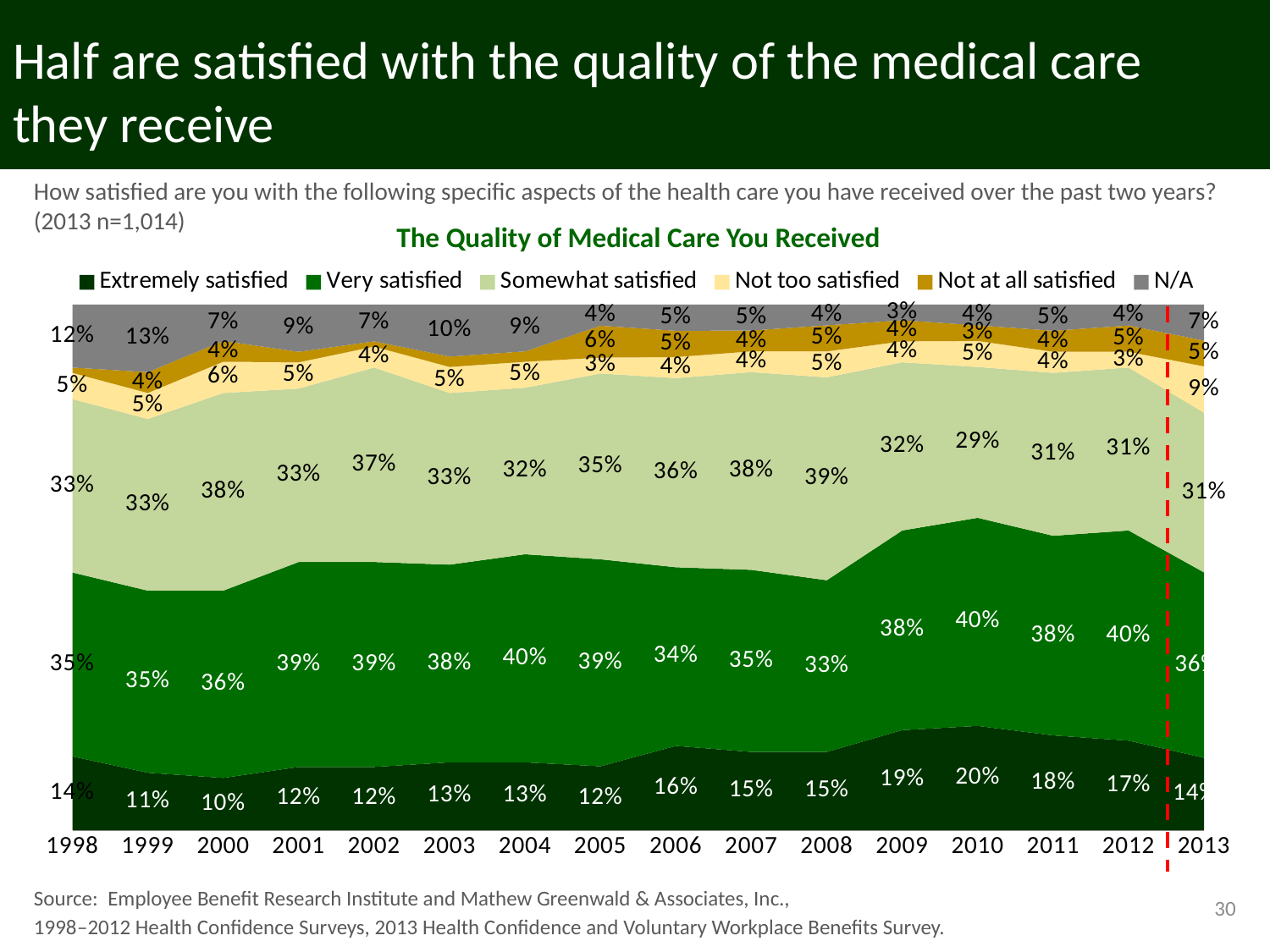
How many series does the chart legend list? 6 In which year was the 'Extremely satisfied' share the lowest? 2000 What percentage of respondents were extremely satisfied with the quality of medical care in 2010? 20% What percentage were very satisfied with the quality of medical care in 2004? 40% What is the N/A percentage for 1999? 13% How many years are shown on the x axis of the chart? 16 What percentage were somewhat satisfied with the quality of medical care in 2008? 39% Which year had a larger 'Somewhat satisfied' share, 2000 or 2001? 2000 In which year was the 'Extremely satisfied' share the highest? 2010 What is the title of the chart? The Quality of Medical Care You Received What is the difference in percentage points between the 'Very satisfied' share in 2004 and in 2008? 7 percentage points What kind of chart is shown on the slide? Stacked area chart